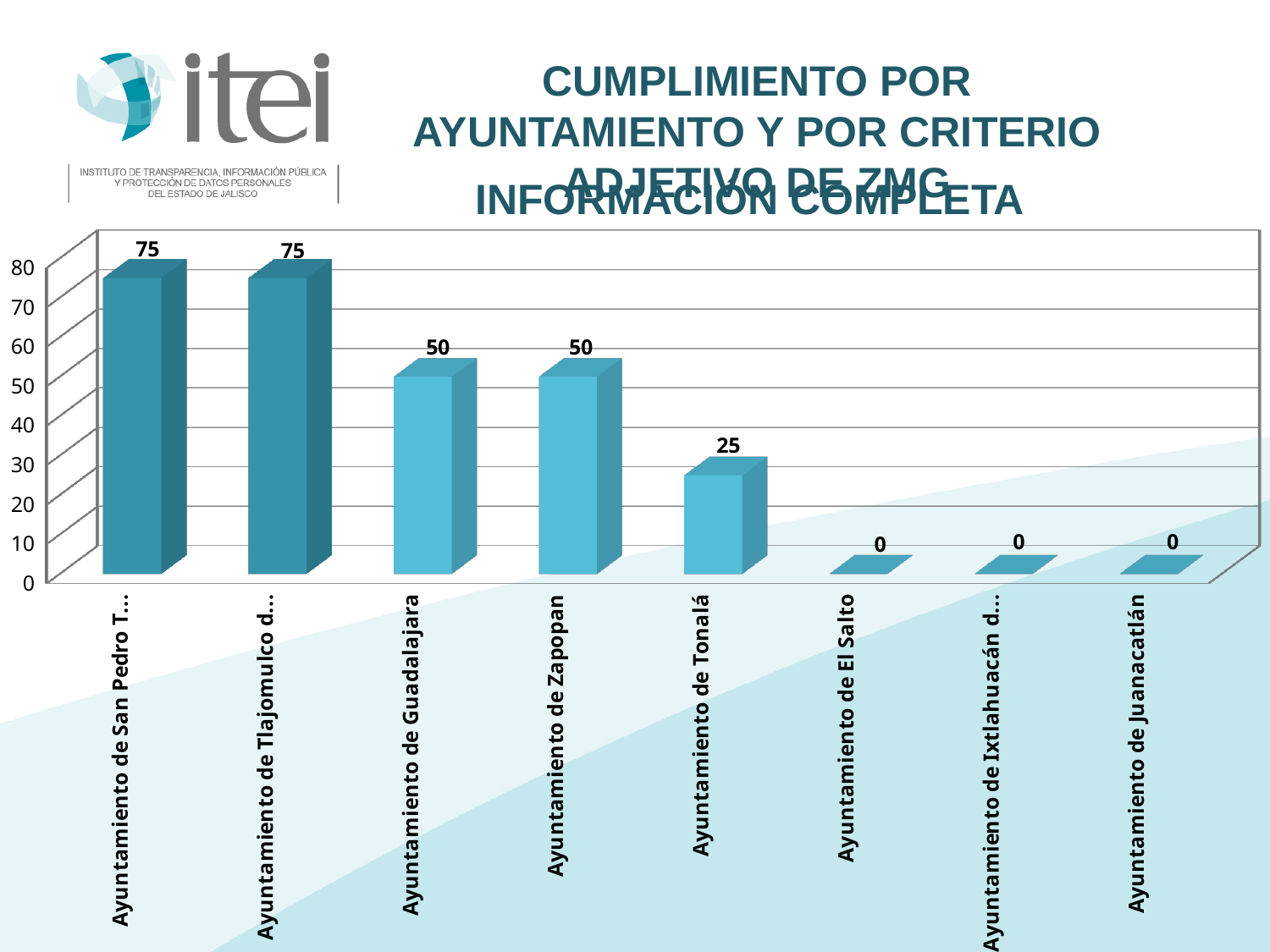
What is the difference between the values for Ayuntamiento de Guadalajara and Ayuntamiento de Tonalá? 25 Which has a larger value, Ayuntamiento de Zapopan or Ayuntamiento de Tonalá? Ayuntamiento de Zapopan What is the value for Ayuntamiento de Guadalajara? 50 How many categories (ayuntamientos) are shown in the chart? 8 What is the highest value shown in the chart? 75 What is the value for Ayuntamiento de Zapopan? 50 What is the value for Ayuntamiento de El Salto? 0 What is the value for Ayuntamiento de Tonalá? 25 Do the values rise or fall from left to right along the x axis? fall Is the value for Ayuntamiento de Tonalá greater or less than 40? less What kind of chart is shown on the slide? bar chart What is the value for Ayuntamiento de Juanacatlán? 0